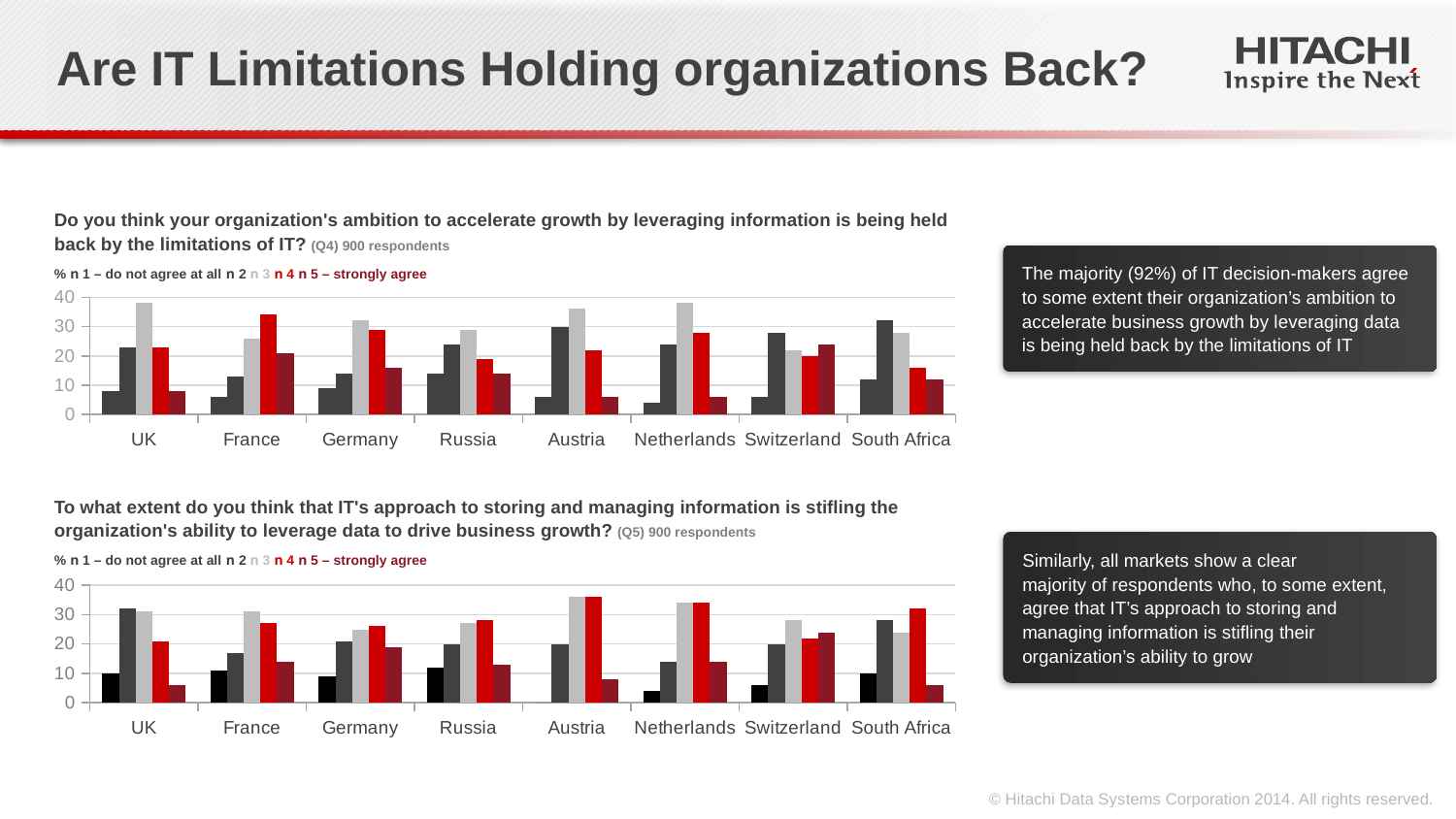
In the top chart (Q4), which is larger for France: the '4' response or the '5 – strongly agree' response? 4 How many response categories does the legend of the top chart (Q4) list? 5 In the top chart (Q4), which country has the larger '1 – do not agree at all' value: Russia or Austria? Russia In the top chart (Q4), is the value for the '3' response in the UK greater or less than 30? greater What kind of chart is the top chart (Q4) on the slide? bar chart How many countries are shown on the x axis of the bottom chart (Q5)? 8 In the top chart (Q4), is the value for '1 – do not agree at all' in the Netherlands greater or less than 10? less In the bottom chart (Q5), which response category has the lowest value for the UK? 5 – strongly agree In the bottom chart (Q5), is the value for the '3' response in Austria greater or less than 30? greater How many respondents does the top chart (Q4) state it is based on? 900 respondents In the top chart (Q4), which response category has the highest value for the UK? 3